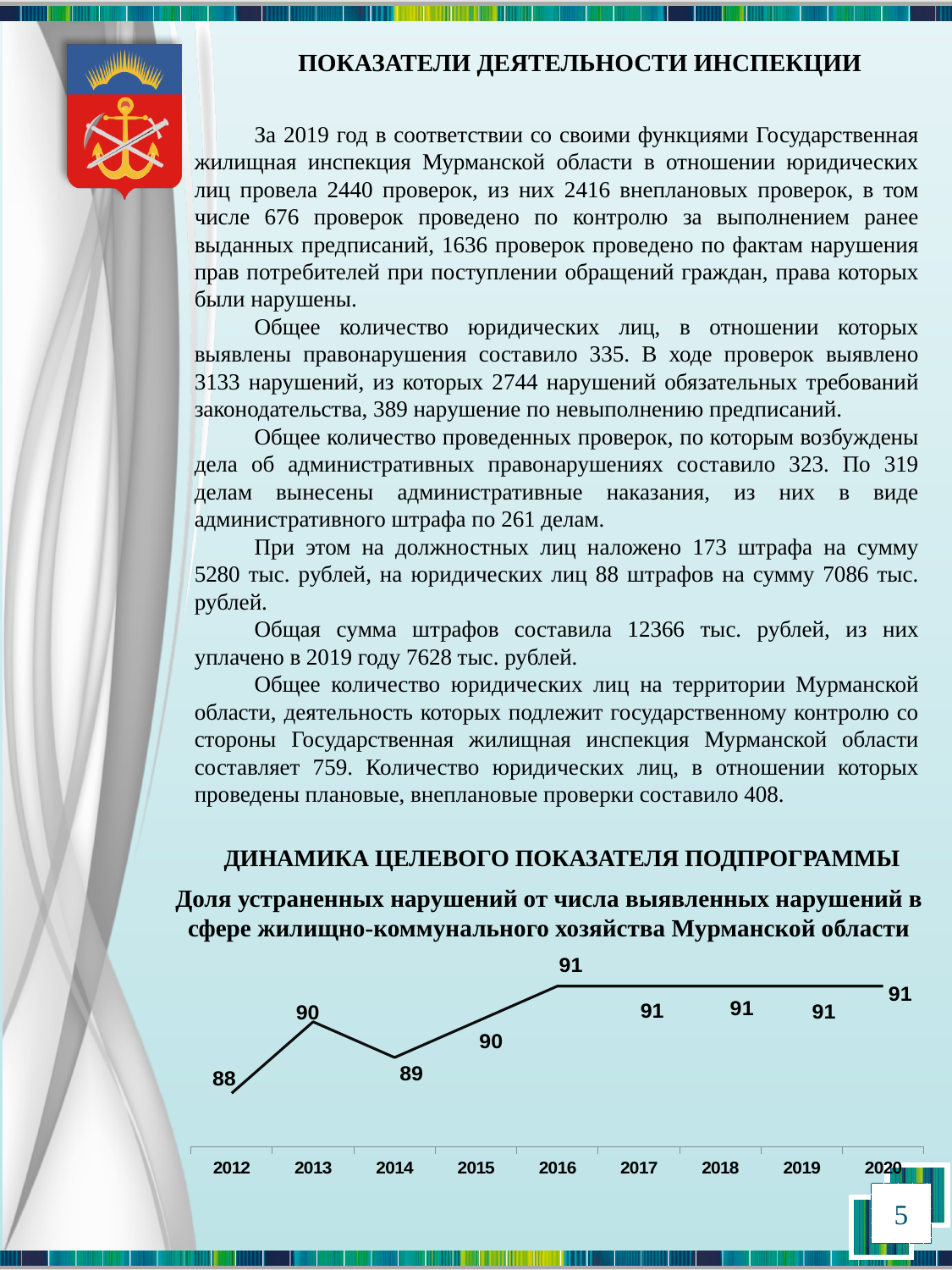
What is the value for 2014 in the line chart? 89 What is the value for 2016 in the line chart? 91 How many years are plotted on the x axis of the line chart? 9 What is the difference between the values for 2016 and 2012 in the line chart? 3 What is the first year shown on the x axis of the line chart? 2012 Which is larger in the line chart, the value for 2013 or the value for 2014? 2013 What is the difference between the values for 2013 and 2012 in the line chart? 2 What type of chart is shown at the bottom of the slide? Line chart What is the value for 2012 in the line chart? 88 What is the value for 2013 in the line chart? 90 Which year has the lowest value in the line chart? 2012 Does the value in the line chart rise or fall from 2012 to 2016? Rise